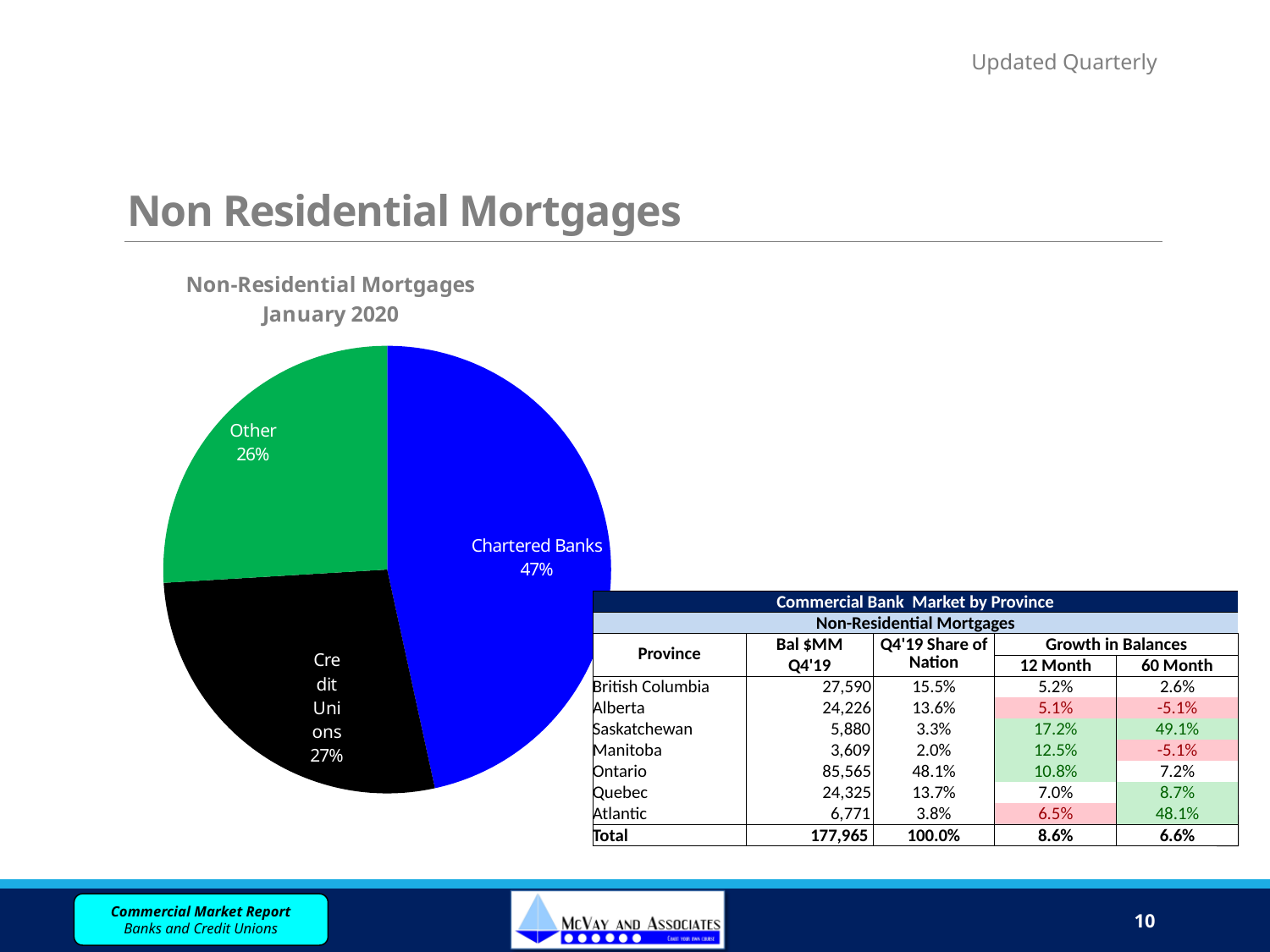
What is the difference in percentage points between the Credit Unions slice and the Other slice? 1 What percentage is shown for Credit Unions in the pie chart? 27% Which slice of the pie chart is the largest? Chartered Banks What is the title of the pie chart? Non-Residential Mortgages January 2020 What is the difference in percentage points between the Chartered Banks slice and the Credit Unions slice? 20 Which is larger in the pie chart, Chartered Banks or Other? Chartered Banks What colour is the Chartered Banks slice in the pie chart? Blue What share of the pie chart does Chartered Banks hold? 47% What percentage is shown for the Other slice in the pie chart? 26% Which slice of the pie chart is the smallest? Other How many slices does the pie chart have? 3 What kind of chart is shown on the slide? Pie chart